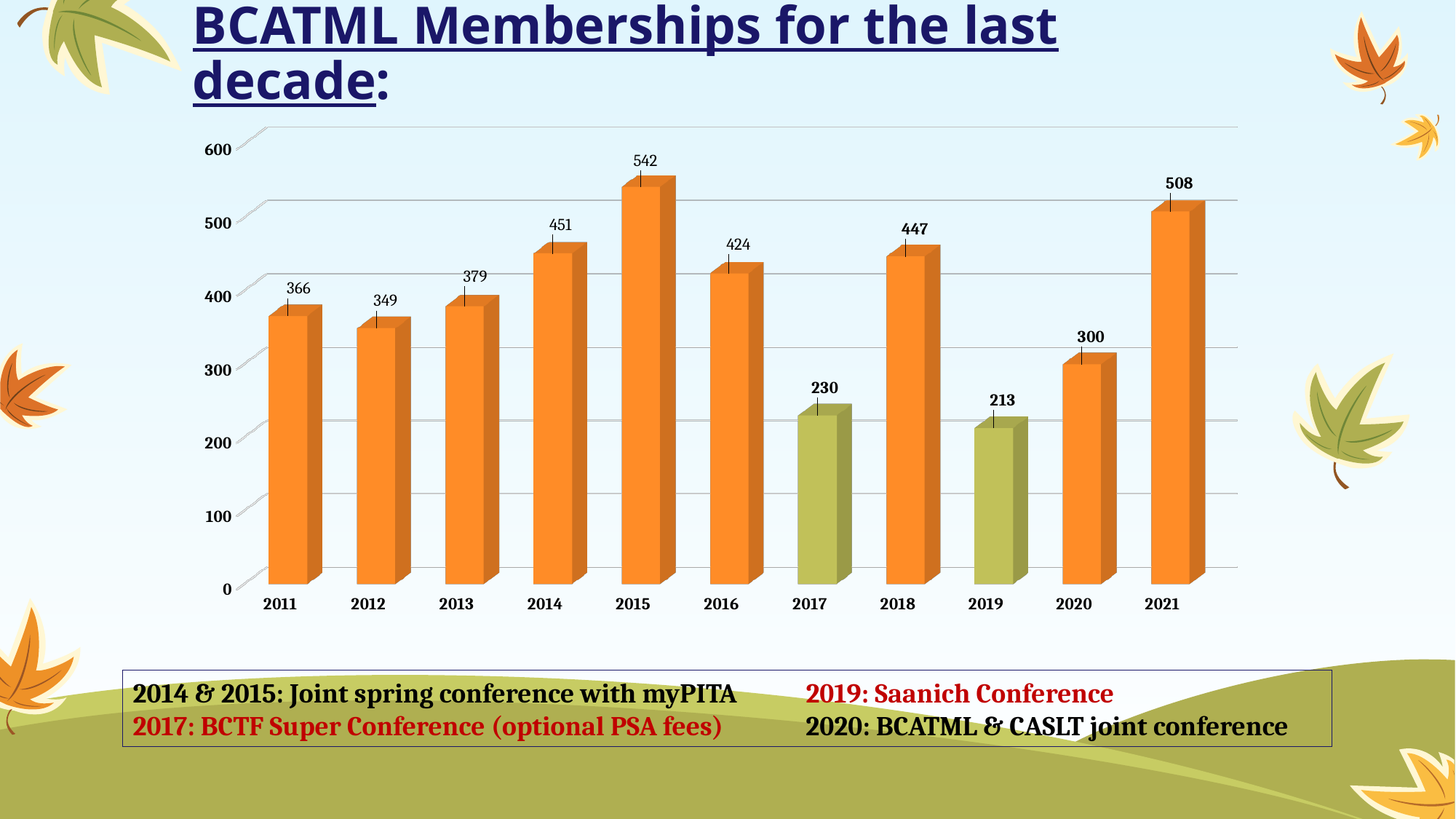
Is the membership value for 2020 greater or less than 400? less What is the difference between the membership values for 2015 and 2021? 34 What kind of chart is shown on the slide? bar chart What is the membership value for 2015? 542 What is the difference between the membership values for 2017 and 2019? 17 What is the membership value for 2021? 508 What is the membership value for 2019? 213 Which year has the lowest membership? 2019 Which year has a larger membership, 2014 or 2018? 2014 Which two years are shown with green bars instead of orange? 2017 and 2019 How many years are shown on the x axis? 11 Which year has the highest membership? 2015